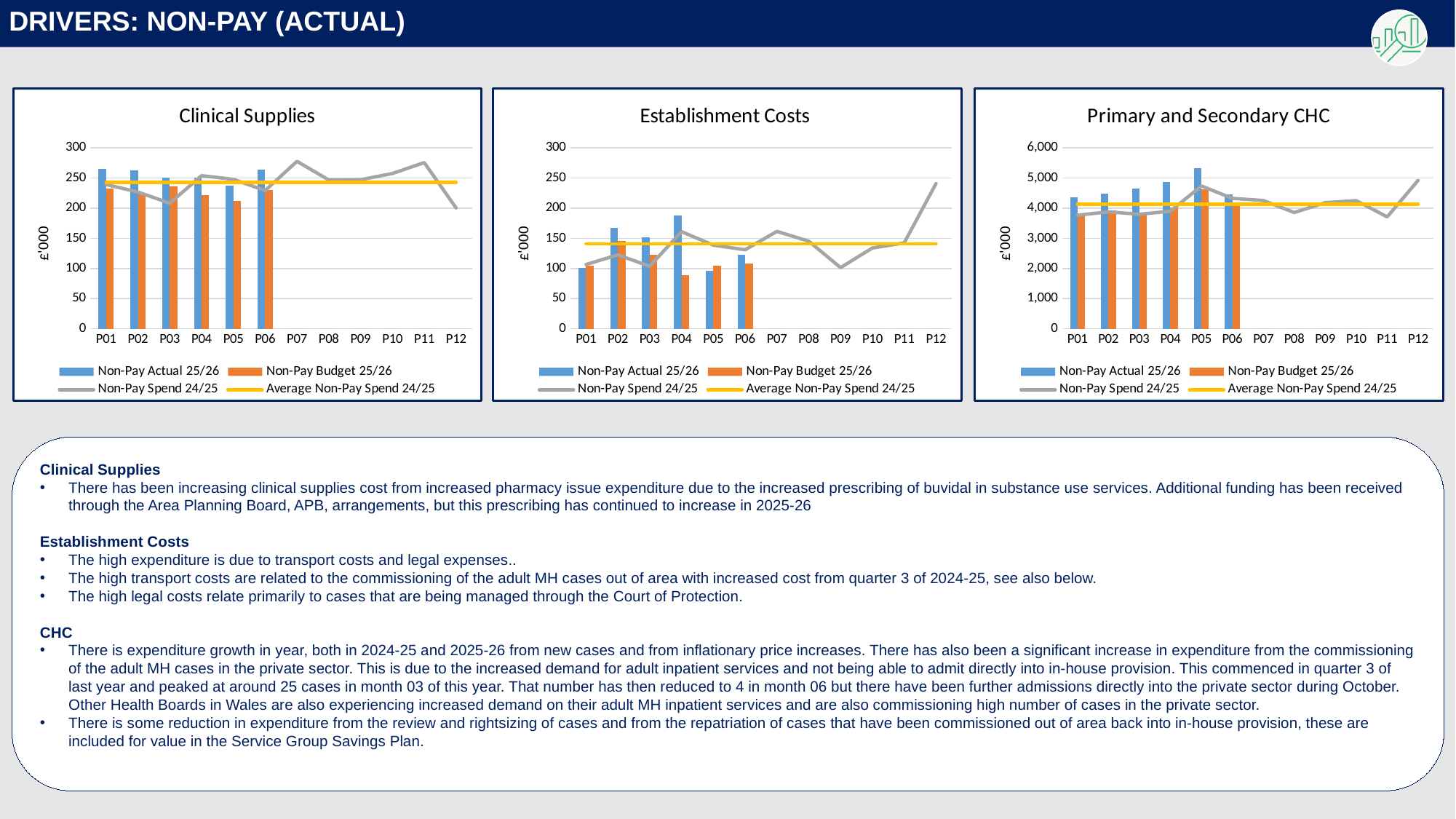
In the Primary and Secondary CHC chart, is the Non-Pay Actual 25/26 value for P05 greater or less than 5,000? greater What is the y-axis label on the Primary and Secondary CHC chart? £'000 In the Establishment Costs chart, which is larger for P04: Non-Pay Actual 25/26 or Non-Pay Budget 25/26? Non-Pay Actual 25/26 In the Clinical Supplies chart, how many periods are shown on the x axis? 12 In the Primary and Secondary CHC chart, which period has the highest Non-Pay Actual 25/26 value? P05 In the Clinical Supplies chart, which period has the lowest Non-Pay Actual 25/26 value? P05 In the Establishment Costs chart, which period has the highest Non-Pay Actual 25/26 value? P04 In the Establishment Costs chart, which period has the lowest Non-Pay Budget 25/26 value? P04 In the Establishment Costs chart, is the Non-Pay Actual 25/26 value for P04 greater or less than 150? greater In the Clinical Supplies chart, is the Non-Pay Budget 25/26 value for P05 greater or less than 250? less In the Clinical Supplies chart, how many series does the legend list? 4